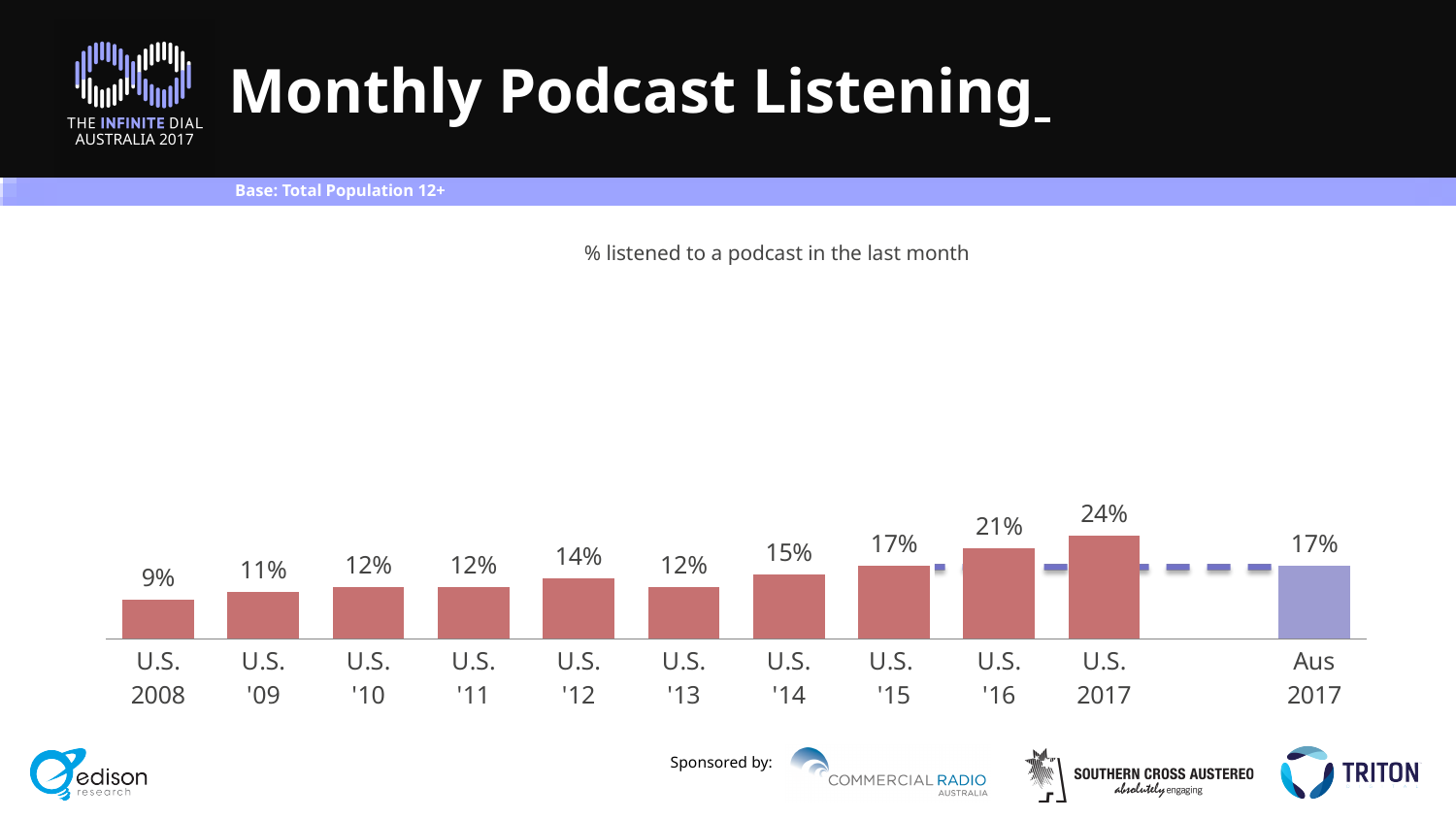
What is the value for U.S. 2008? 9% What is the difference between the values for U.S. 2017 and Aus 2017? 7% What is the value for U.S. '16? 21% Which category has the lowest value? U.S. 2008 What is the title of the chart? Monthly Podcast Listening Which is larger, the value for U.S. '14 or the value for U.S. '13? U.S. '14 How many categories are shown on the x axis? 11 What is the value for Aus 2017? 17% What is the difference between the values for U.S. '16 and U.S. '15? 4% Which category has the highest value? U.S. 2017 What kind of chart is this? bar chart Do the U.S. values generally rise or fall from 2008 to 2017? rise